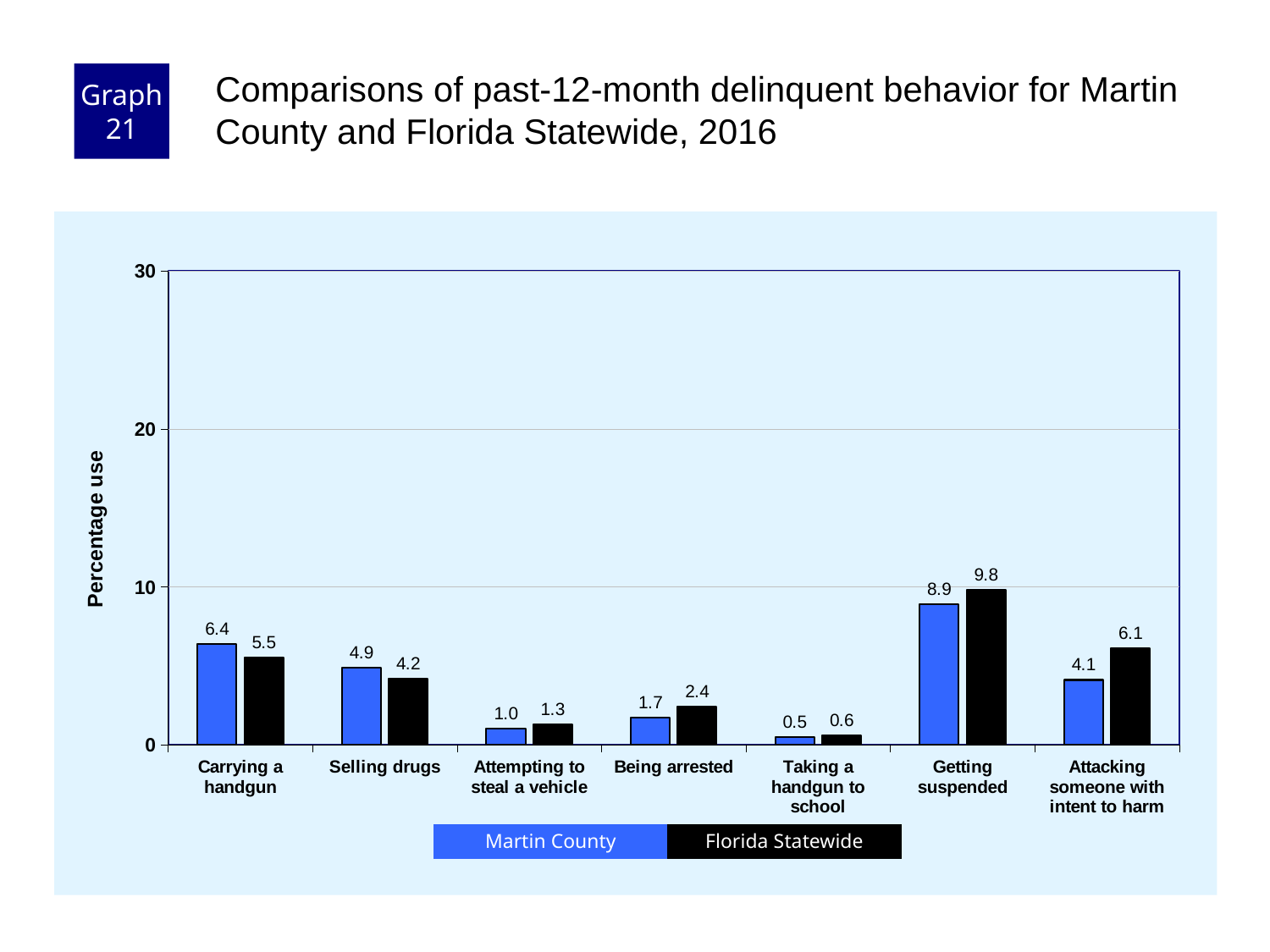
Is the Florida Statewide value for Getting suspended greater or less than 10? less How many categories are shown on the x axis? 7 Which category has the highest Florida Statewide value? Getting suspended What is the label of the y axis? Percentage use For Carrying a handgun, which is larger: the Martin County value or the Florida Statewide value? Martin County What is the Martin County value for Getting suspended? 8.9 How many series does the legend list? 2 What is the Florida Statewide value for Being arrested? 2.4 Which category has the lowest Martin County value? Taking a handgun to school What kind of chart is shown on the slide? bar chart What is the Martin County value for Taking a handgun to school? 0.5 What is the difference between the Florida Statewide and Martin County values for Attacking someone with intent to harm? 2.0